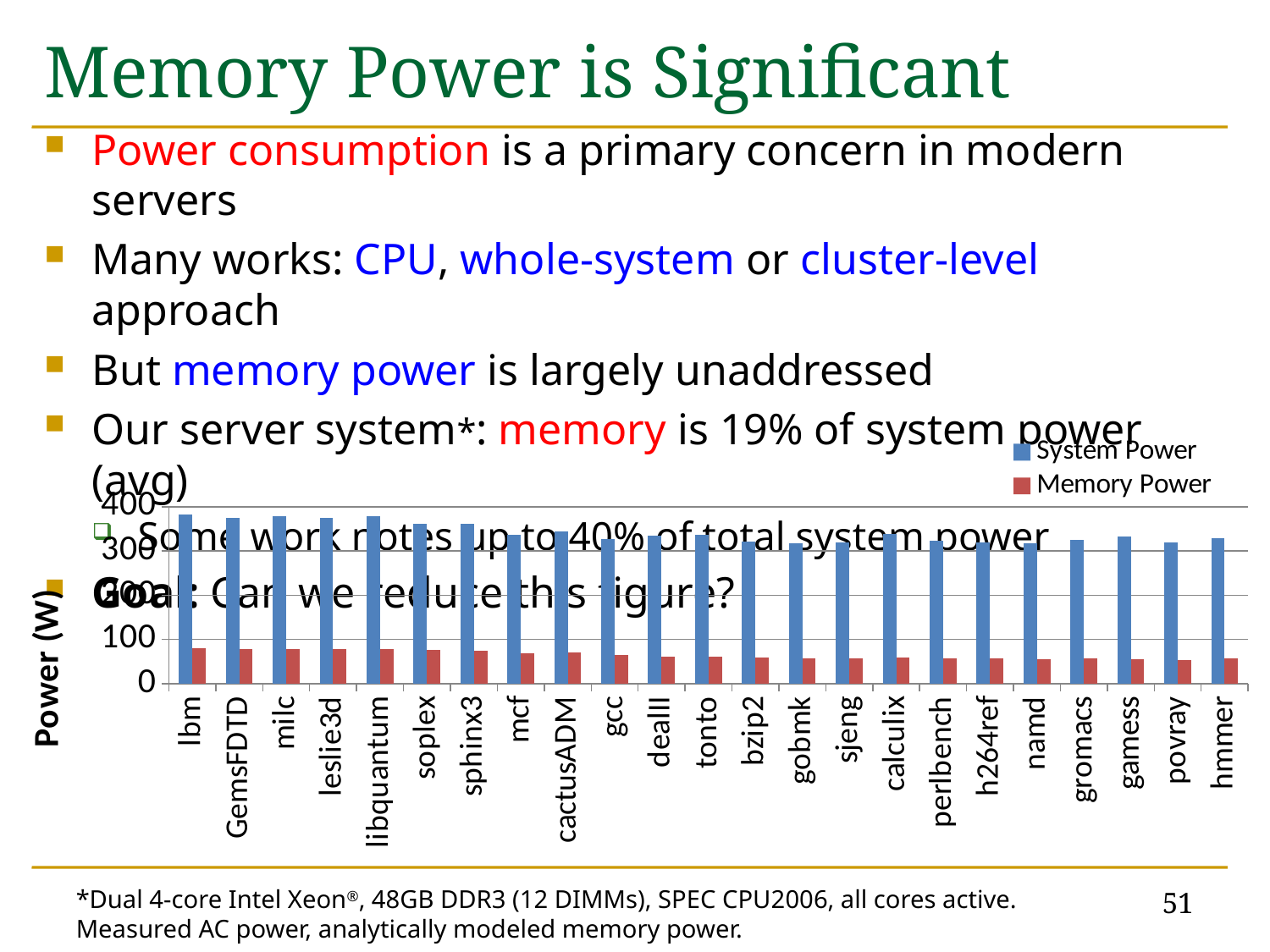
Is the System Power value for hmmer greater or less than 200? greater What is the label on the y axis of the chart? Power (W) Which is larger for gcc: System Power or Memory Power? System Power Which is larger: the System Power for lbm or the System Power for povray? lbm Do the System Power values generally rise or fall moving from left to right along the x axis? fall How many benchmarks (categories) are plotted along the x axis? 23 Is the Memory Power value for lbm greater or less than 100? less Which colour represents Memory Power in the chart legend? red How many series does the chart legend list? 2 What kind of chart is shown on the slide? bar chart Is the System Power value for lbm greater or less than 300? greater